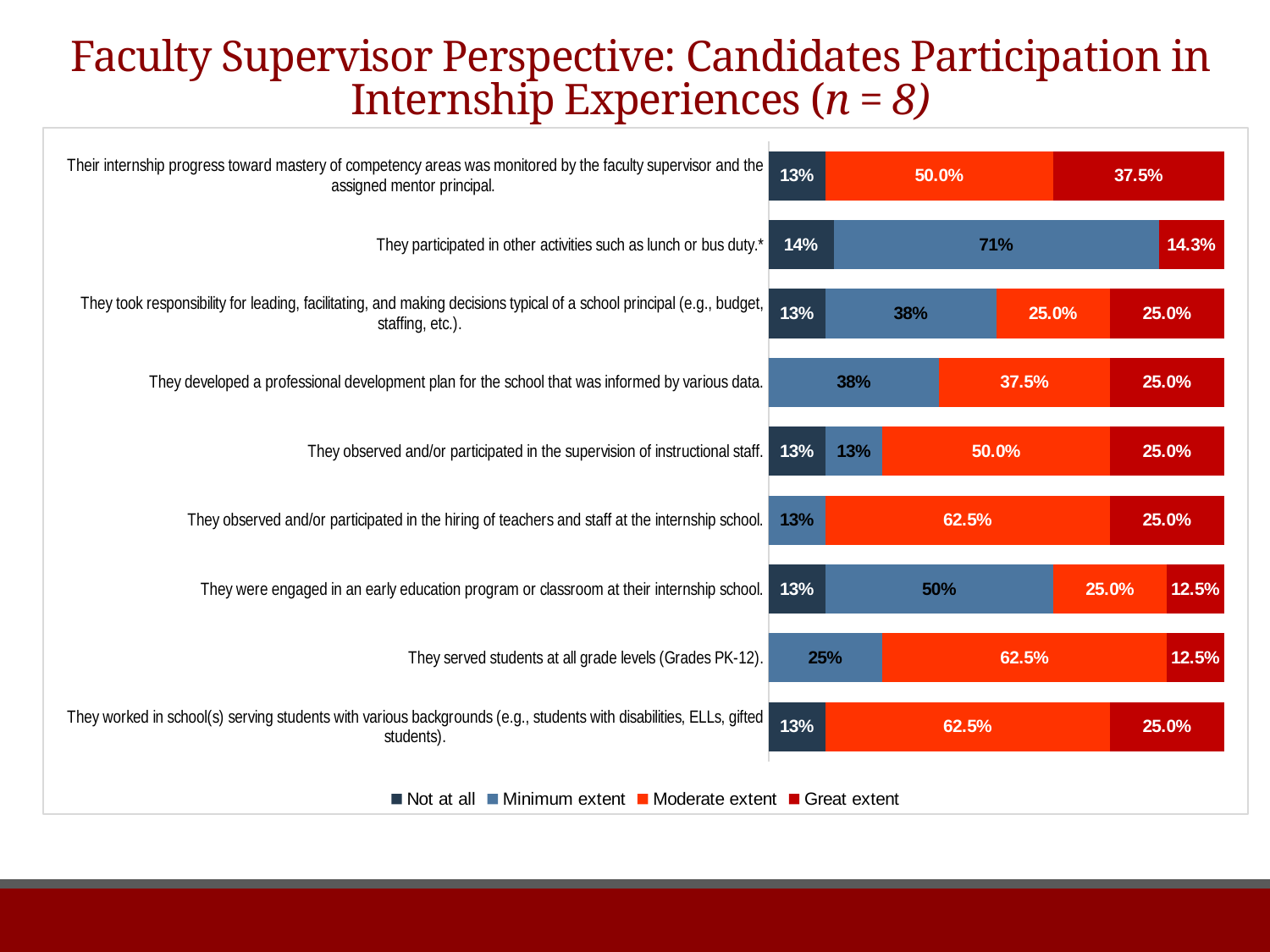
What is the Minimum extent value for "They participated in other activities such as lunch or bus duty.*"? 71% How many categories (statements) are plotted in the chart? 9 What is the Moderate extent value for "They observed and/or participated in the hiring of teachers and staff at the internship school."? 62.5% For "They were engaged in an early education program or classroom at their internship school.", which is larger: the Minimum extent value or the Moderate extent value? Minimum extent What is the difference between the Moderate extent and Great extent values for "They developed a professional development plan for the school that was informed by various data."? 12.5% How many series does the legend list? 4 Which statement has the highest Minimum extent value? They participated in other activities such as lunch or bus duty.* What is the Great extent value for "Their internship progress toward mastery of competency areas was monitored by the faculty supervisor and the assigned mentor principal."? 37.5% What is the Great extent value for "They served students at all grade levels (Grades PK-12)."? 12.5% What kind of chart is shown on the slide? Stacked bar chart Which statement has the highest Great extent value? Their internship progress toward mastery of competency areas was monitored by the faculty supervisor and the assigned mentor principal. Which legend entry is shown in dark red? Great extent